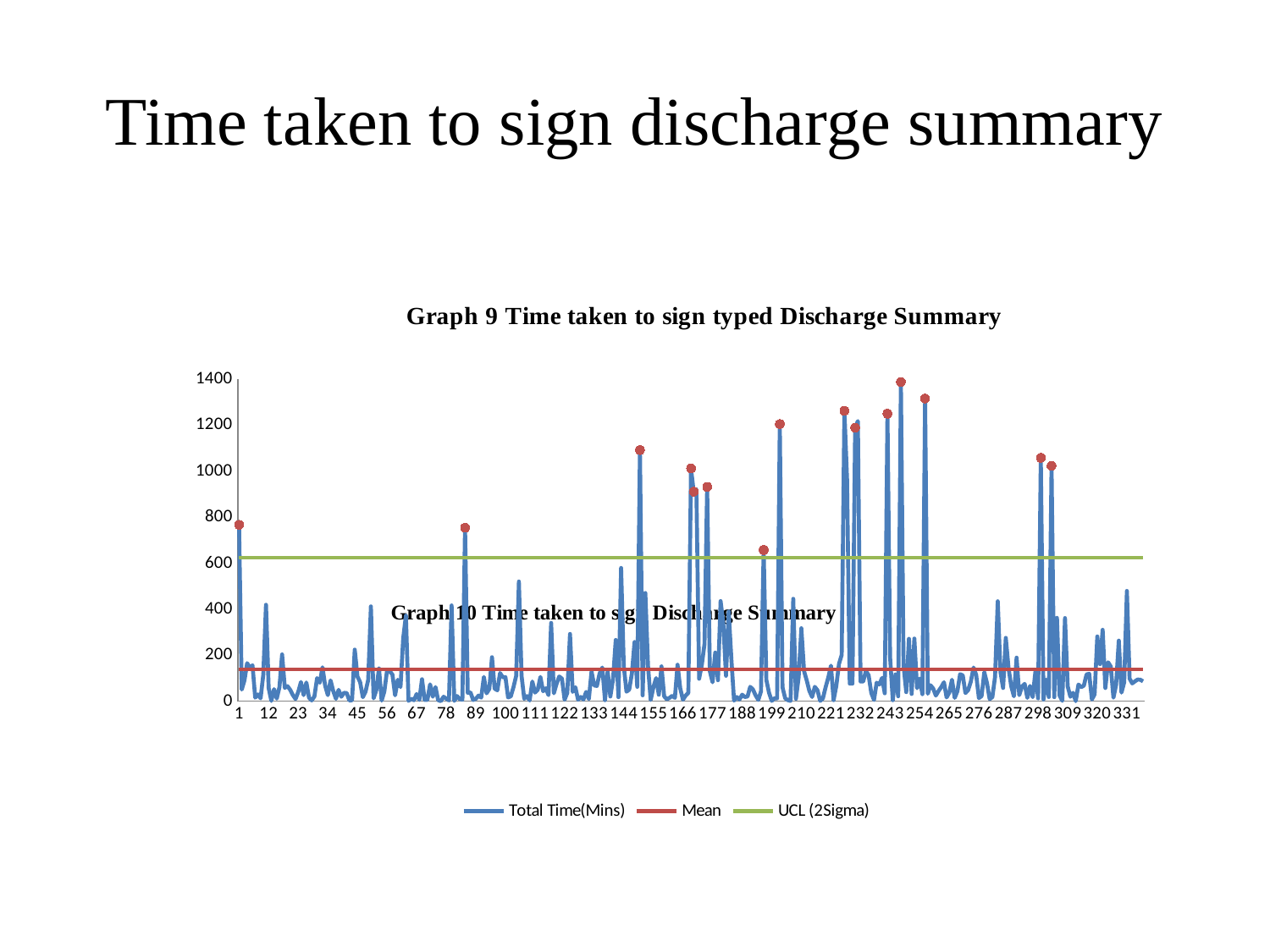
Is the highest peak of the Total Time(Mins) series greater or less than 1200? greater What is the highest value shown on the vertical axis? 1400 Is the value of the UCL (2Sigma) line greater or less than 800? less Is the value of the UCL (2Sigma) line greater or less than 400? greater Which line is higher on the chart, the Mean line or the UCL (2Sigma) line? UCL (2Sigma) How many series does the legend list? 3 What is the last label shown on the horizontal axis? 331 What is the title of the chart? Graph 9 Time taken to sign typed Discharge Summary What kind of chart is shown on the slide? line chart